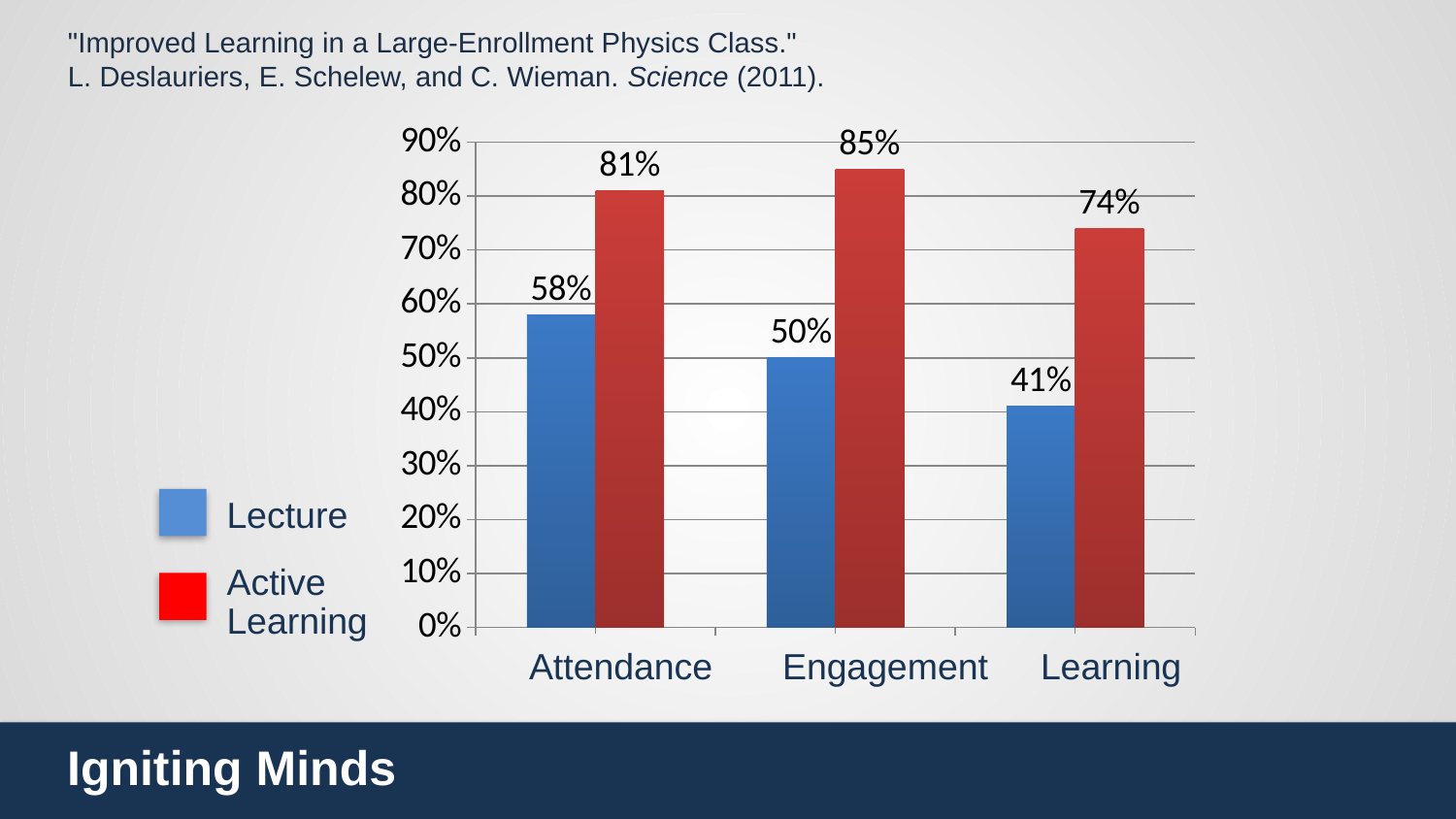
What is the difference between the Active Learning and Lecture values for Attendance? 23% What is the Lecture value for Attendance? 58% Which is larger for Engagement, the Lecture value or the Active Learning value? Active Learning What is the Lecture value for Learning? 41% How many categories are shown on the x axis? 3 What kind of chart is shown on the slide? Bar chart Which category has the highest Active Learning value? Engagement What is the Active Learning value for Engagement? 85% Which category has the lowest Lecture value? Learning How many series does the legend list? 2 What is the difference between the Active Learning and Lecture values for Learning? 33% What is the Active Learning value for Learning? 74%